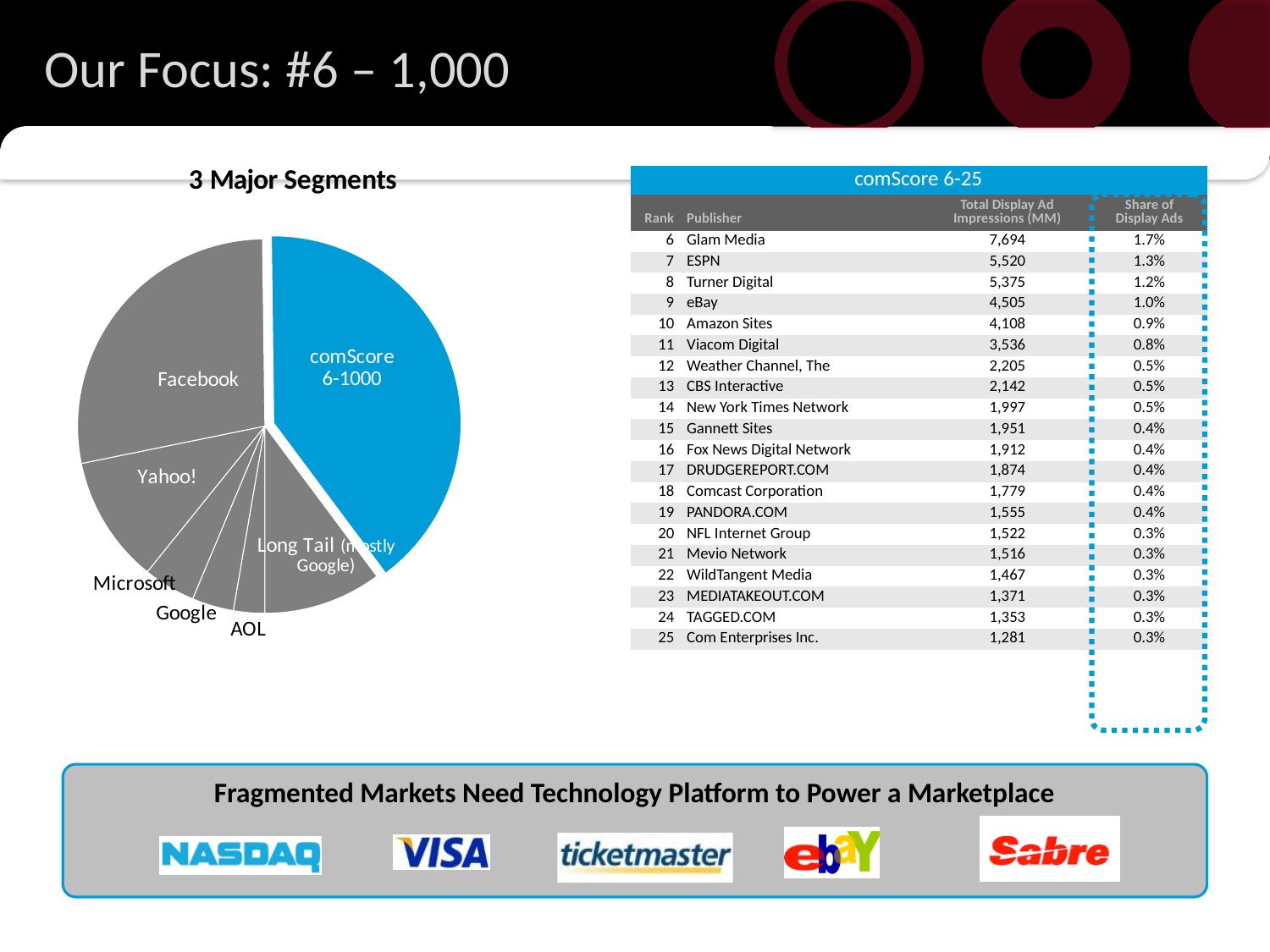
In the "3 Major Segments" pie chart, which slice is larger, Long Tail (mostly Google) or Microsoft? Long Tail (mostly Google) What kind of chart is shown under the heading "3 Major Segments"? pie chart Which slice is the largest in the "3 Major Segments" pie chart? comScore 6-1000 In the "3 Major Segments" pie chart, which slice is larger, comScore 6-1000 or Yahoo!? comScore 6-1000 In the "3 Major Segments" pie chart, which slice is larger, Facebook or Yahoo!? Facebook How many slices does the "3 Major Segments" pie chart have? 7 Which slice of the "3 Major Segments" pie chart is coloured blue rather than gray? comScore 6-1000 What is the title of the pie chart on the slide? 3 Major Segments